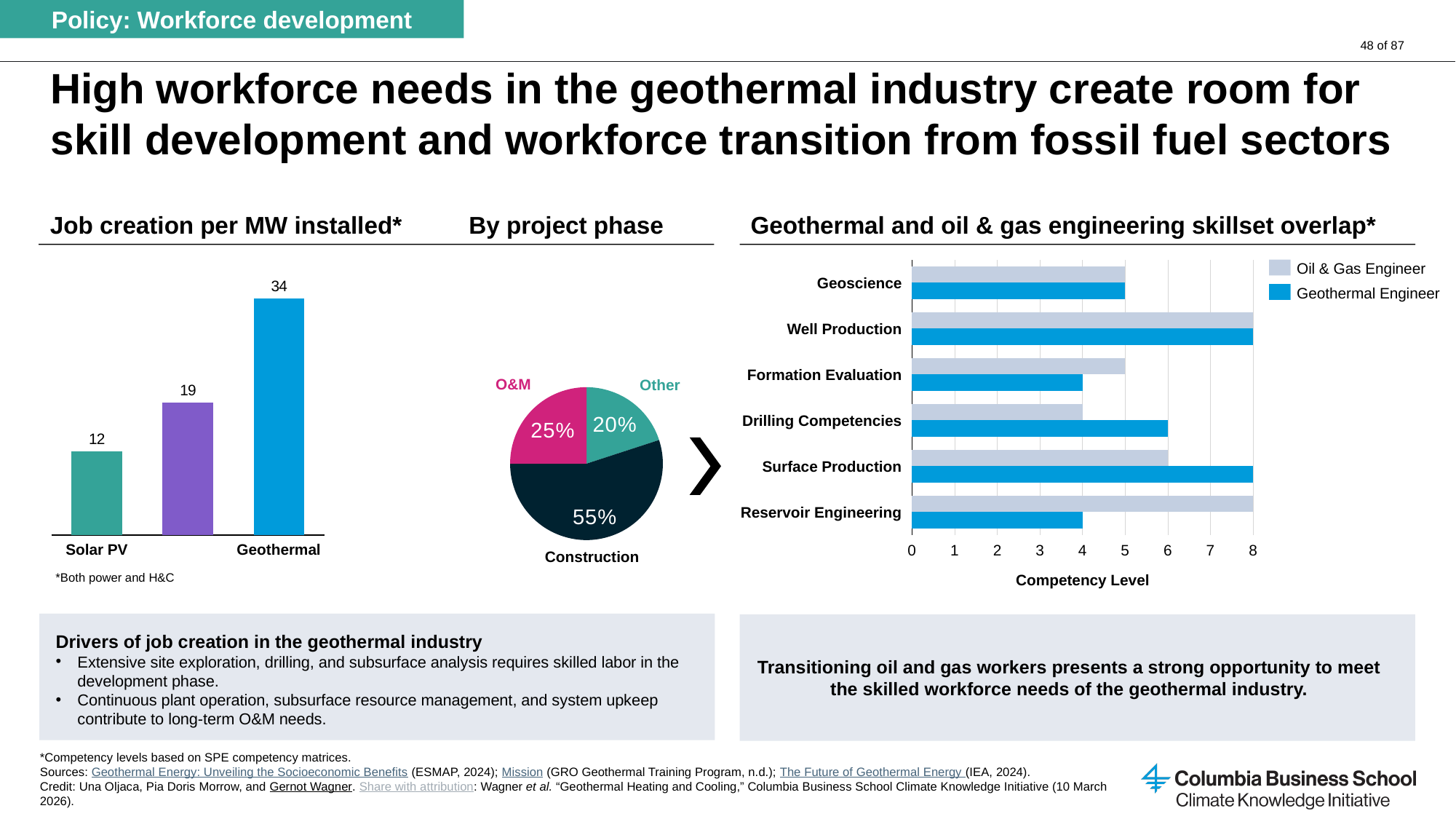
How many competency categories are shown in the 'Geothermal and oil & gas engineering skillset overlap' chart? 6 In the 'Geothermal and oil & gas engineering skillset overlap' chart, which is larger for Reservoir Engineering: Oil & Gas Engineer or Geothermal Engineer? Oil & Gas Engineer How many series does the legend list in the 'Geothermal and oil & gas engineering skillset overlap' chart? 2 In the 'By project phase' pie chart, what share does Construction have? 55% What kind of chart is the 'By project phase' chart? Pie chart In the 'Geothermal and oil & gas engineering skillset overlap' chart, what is the competency level of the Geothermal Engineer for Surface Production? 8 In the 'Job creation per MW installed' chart, which labeled category has the highest value? Geothermal In the 'By project phase' pie chart, what share does O&M have? 25% In the 'Job creation per MW installed' chart, what is the difference between Geothermal and Solar PV? 22 In the 'Job creation per MW installed' chart, what is the value for Geothermal? 34 In the 'By project phase' pie chart, which slice is the smallest? Other In the 'Job creation per MW installed' chart, what is the value for Solar PV? 12